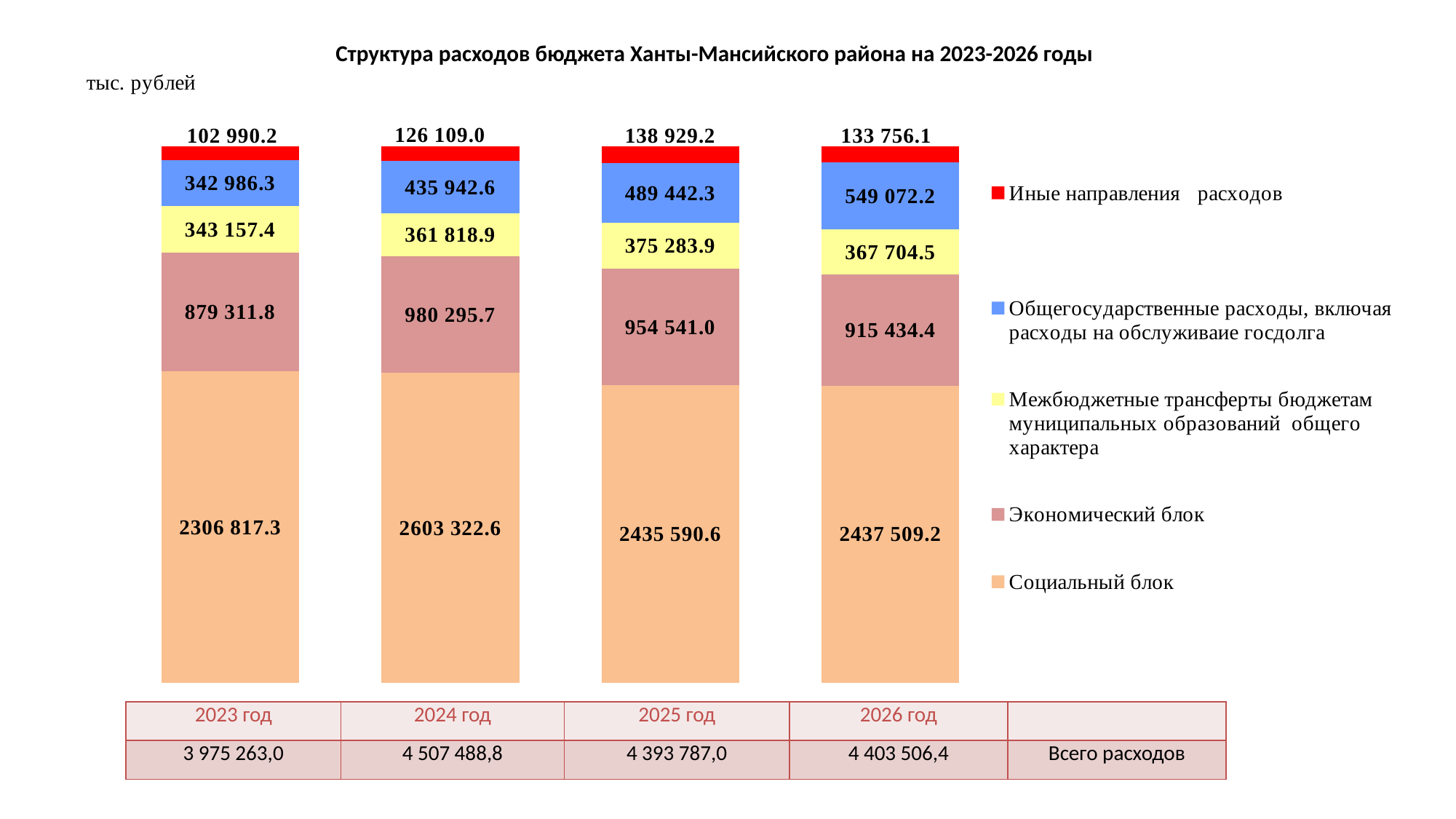
How many series does the legend list? 5 Does the value of Общегосударственные расходы, включая расходы на обслуживаие госдолга rise or fall from 2023 год to 2026 год? rise What is the difference between Социальный блок in 2024 год and in 2023 год? 296 505.3 Which year has the larger value for Экономический блок, 2024 год or 2025 год? 2024 год In which year is Иные направления расходов the lowest? 2023 год What is the total of all expenditures (Всего расходов) for 2023 год? 3 975 263,0 What is the value of Общегосударственные расходы, включая расходы на обслуживаие госдолга for 2026 год? 549 072.2 What is the value of Социальный блок for 2023 год? 2306 817.3 What is the value of Экономический блок for 2025 год? 954 541.0 In which year is Социальный блок the highest? 2024 год How many years (bars) are shown in the chart? 4 What is the value of Иные направления расходов for 2024 год? 126 109.0